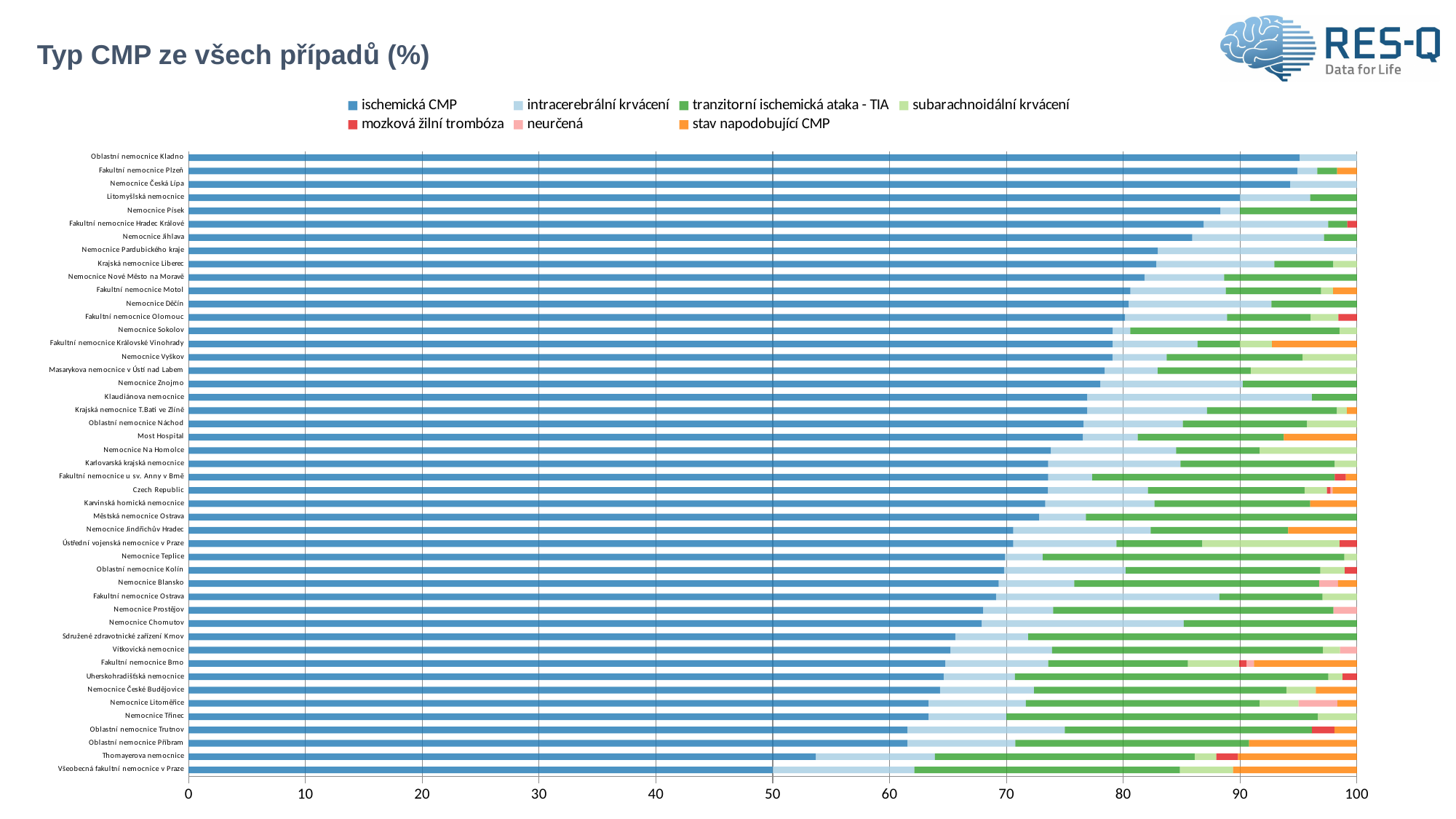
How many series does the legend list? 7 Which hospital has the smallest share of ischemická CMP? Všeobecná fakultní nemocnice v Praze Is the ischemická CMP value for Nemocnice Jihlava greater or less than 80? greater What kind of chart is shown on the slide? stacked bar chart Which hospital has the largest share of ischemická CMP? Oblastní nemocnice Kladno Which colour represents stav napodobující CMP in the legend? orange Which has a larger ischemická CMP share, Nemocnice Písek or Nemocnice Teplice? Nemocnice Písek Is the ischemická CMP value for Thomayerova nemocnice greater or less than 60? less Is the ischemická CMP value for Oblastní nemocnice Kladno greater or less than 90? greater What is the title of the chart? Typ CMP ze všech případů (%) Do the ischemická CMP values rise or fall going from the top bar to the bottom bar? fall